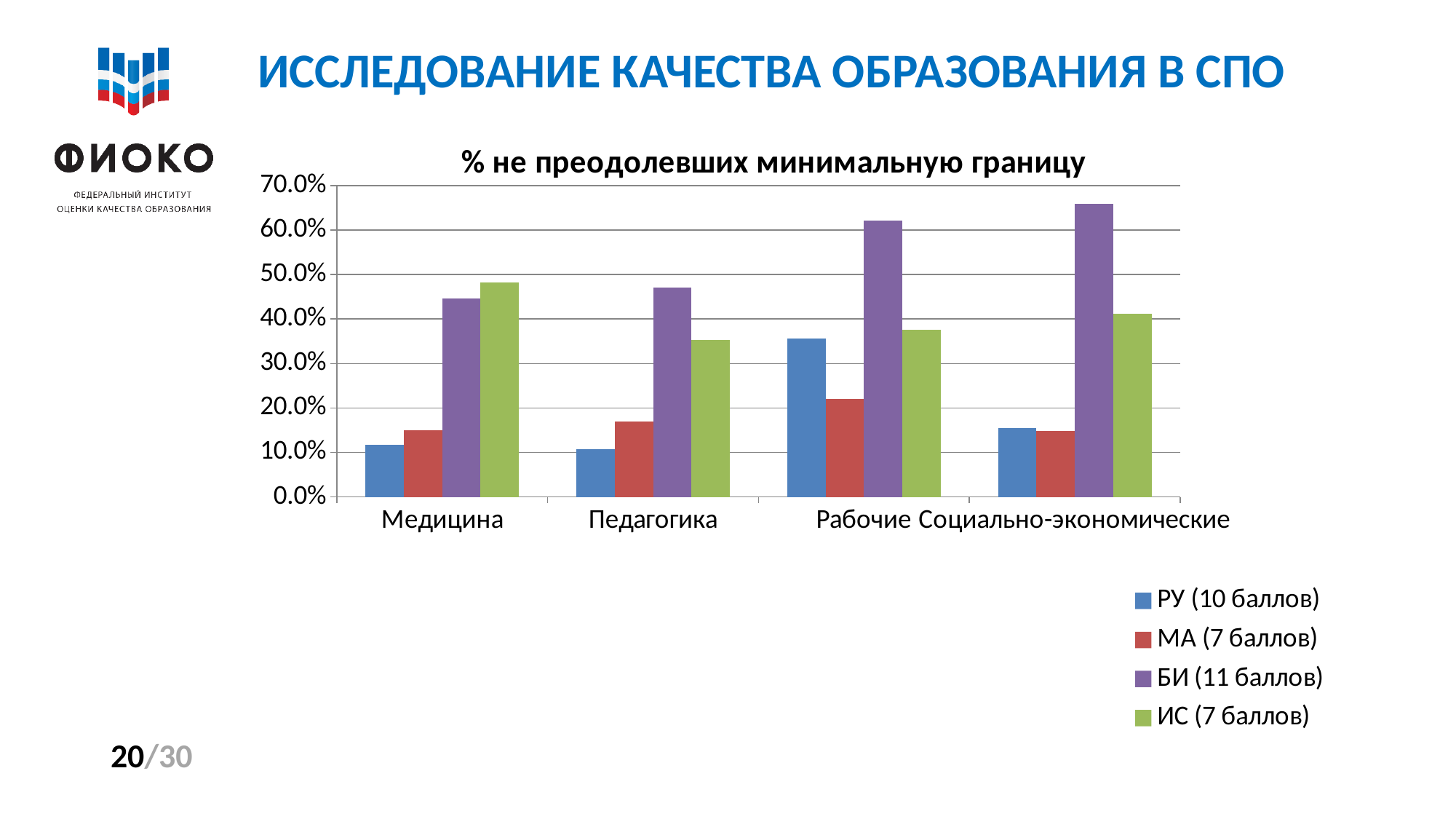
How many categories are shown on the x axis? 4 What is the title of the chart? % не преодолевших минимальную границу For which category is the value of РУ (10 баллов) the highest? Рабочие For Педагогика, which is larger: БИ (11 баллов) or ИС (7 баллов)? БИ (11 баллов) Is the value of ИС (7 баллов) for Медицина greater or less than 50.0%? less Is the value of РУ (10 баллов) for Рабочие greater or less than 30.0%? greater For which category is the value of БИ (11 баллов) the highest? Социально-экономические Is the value of БИ (11 баллов) for Рабочие greater or less than 60.0%? greater What kind of chart is shown on the slide? bar chart Within the Рабочие category, which series has the highest value? БИ (11 баллов) How many series does the legend list? 4 Which series is shown in purple in the legend? БИ (11 баллов)